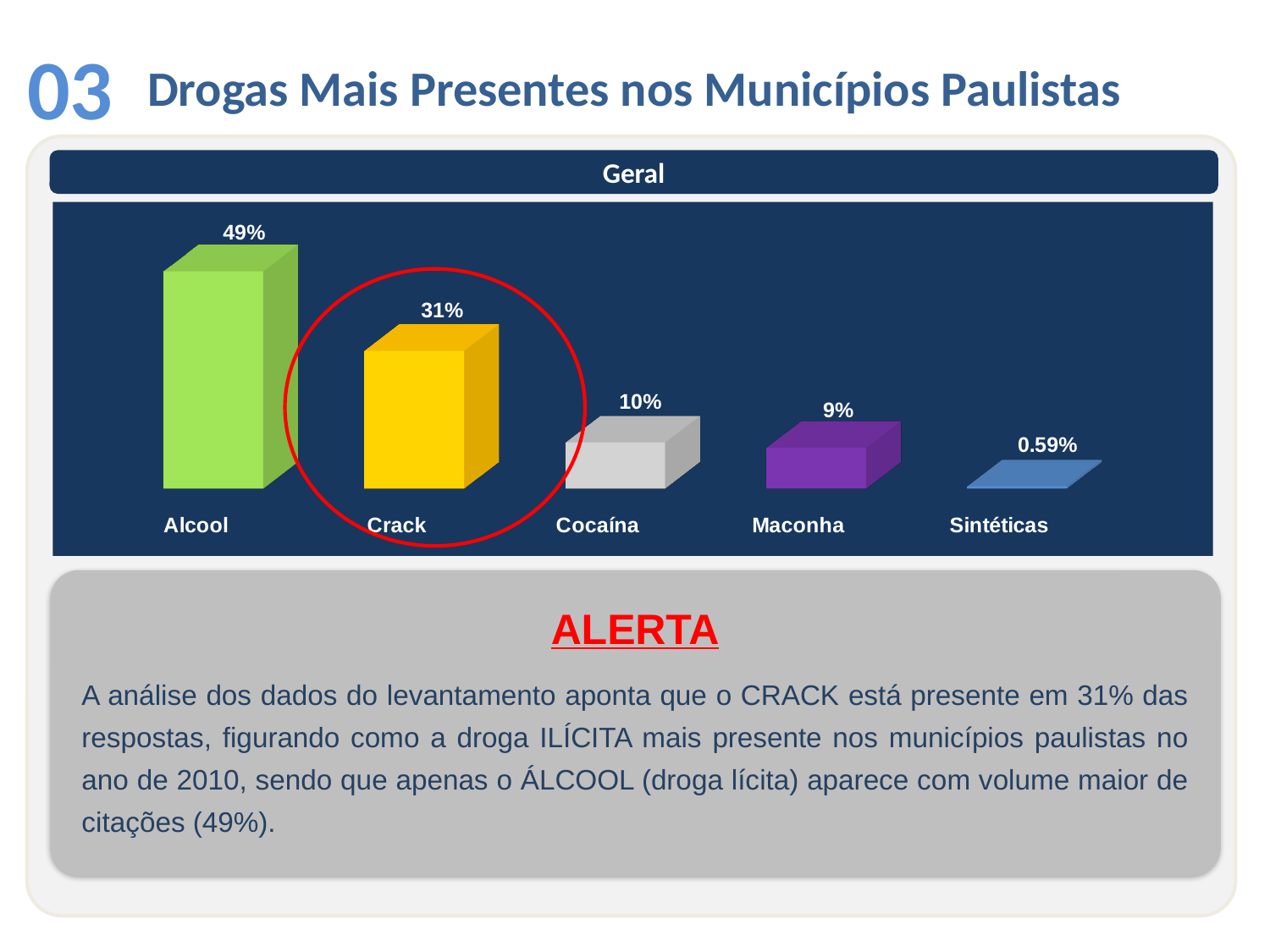
What is the value for Sintéticas? 0.59% What is the value for Alcool? 49% What is the difference between the values for Alcool and Crack? 18% What kind of chart is shown on the slide? Bar chart Which category has the lowest value? Sintéticas How many categories are shown in the chart? 5 What is the value for Cocaína? 10% Which category is circled in red on the chart? Crack Which is larger, the value for Crack or the value for Cocaína? Crack Which category has the highest value? Alcool What is the value for Crack? 31% What is the value for Maconha? 9%